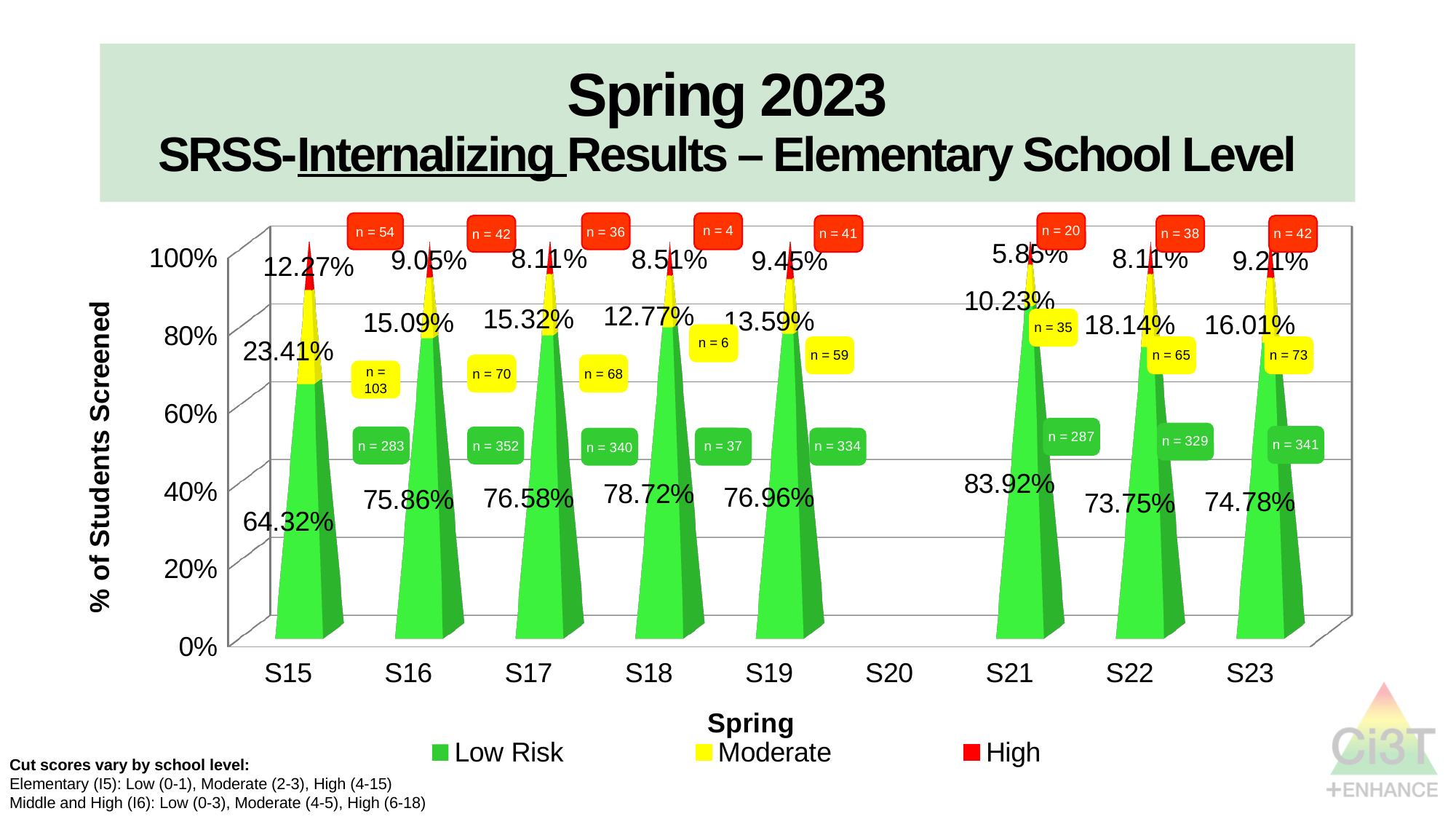
How many series does the legend list? 3 What is the Low Risk percentage for S15? 64.32% Which spring has the highest Low Risk percentage? S21 Which spring has the lowest Low Risk percentage? S15 What kind of chart is shown on the slide? Stacked bar chart What is the difference between the Low Risk percentage for S21 and for S15? 19.60% How many spring categories are labeled on the x axis? 9 What is the High percentage for S21? 5.85% What is the Moderate percentage for S18? 12.77% Which spring has the highest High percentage? S15 Which spring has the lowest Moderate percentage? S21 Which has a larger Moderate percentage, S22 or S23? S22